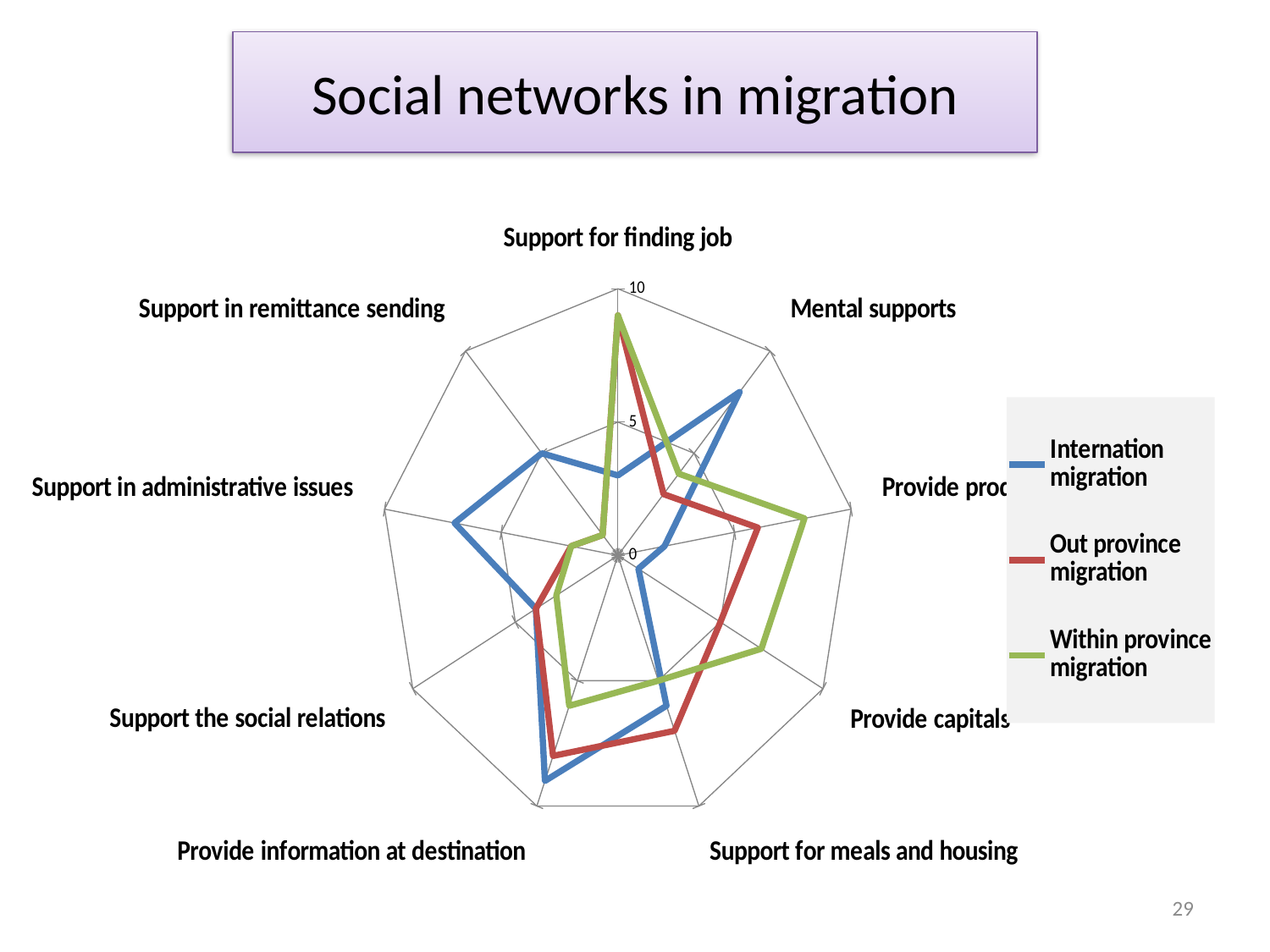
Is the value for Within province migration on Support for finding job greater or less than 5? greater Which series has the highest value for Support in administrative issues? Internation migration Which series has the highest value for Mental supports? Internation migration How many series does the legend list? 3 Is the value for Out province migration on Support in administrative issues greater or less than 5? less Which series has the lowest value for Support for finding job? Internation migration What kind of chart is shown on the slide? Radar chart How many categories (axes) does the radar chart have? 9 What is the title of the slide? Social networks in migration Is the value for Internation migration on Support for finding job greater or less than 5? less